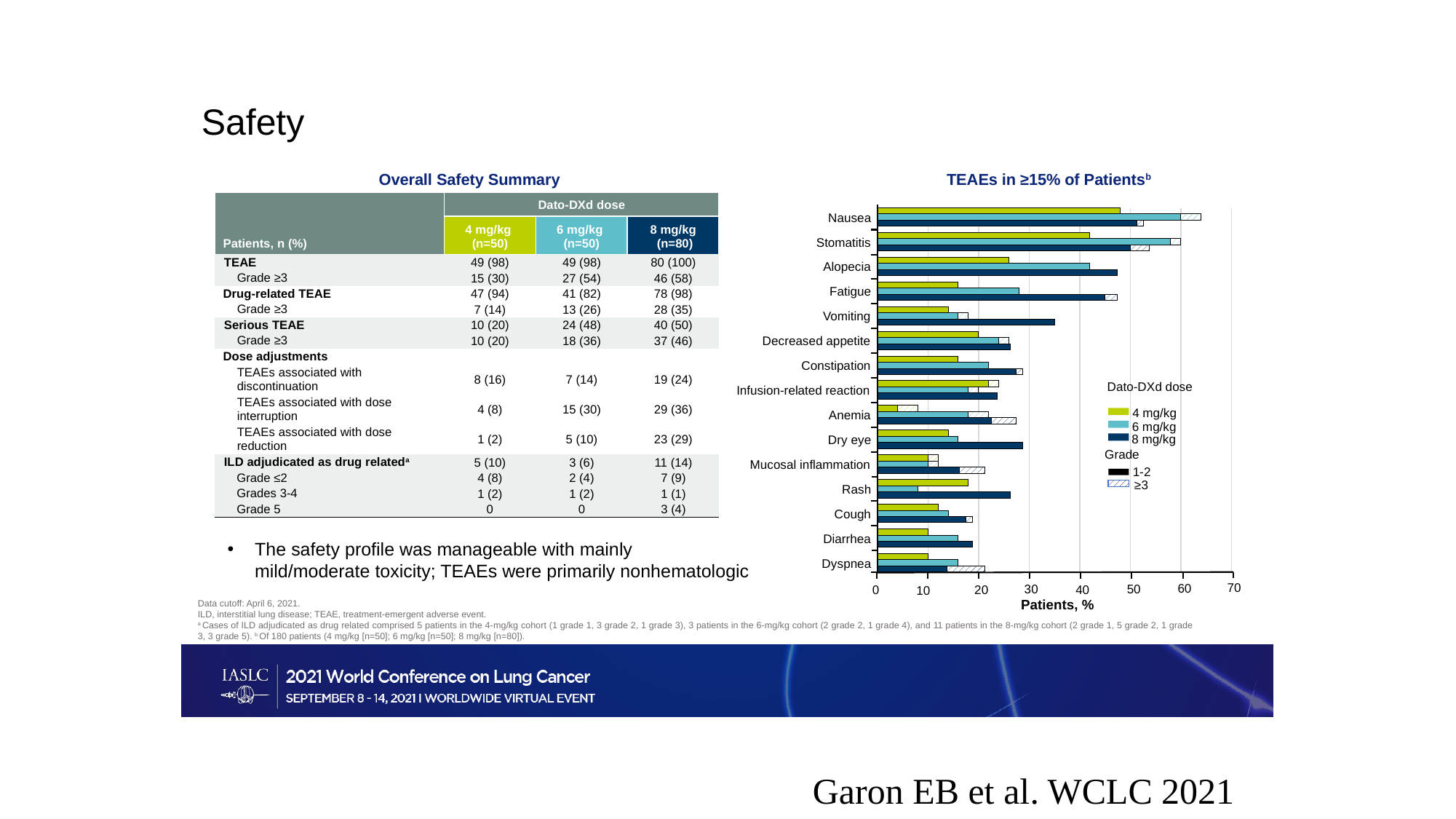
In the TEAEs chart, which adverse event has the longest bar overall? Nausea In the TEAEs chart, is the 8 mg/kg value for Vomiting greater or less than 30? greater In the TEAEs chart, is the 4 mg/kg value for Anemia greater or less than 10? less What kind of chart is shown under the title "TEAEs in ≥15% of Patients"? bar chart What is the x-axis title of the TEAEs chart? Patients, % How many Dato-DXd dose groups does the legend of the TEAEs chart list? 3 In the TEAEs chart, is the 6 mg/kg value for Nausea greater or less than 60? greater In the TEAEs chart, which is larger for the 4 mg/kg dose: Nausea or Alopecia? Nausea In the TEAEs chart, which is larger for Vomiting: the 4 mg/kg value or the 8 mg/kg value? 8 mg/kg How many adverse event categories are listed on the y axis of the TEAEs chart? 15